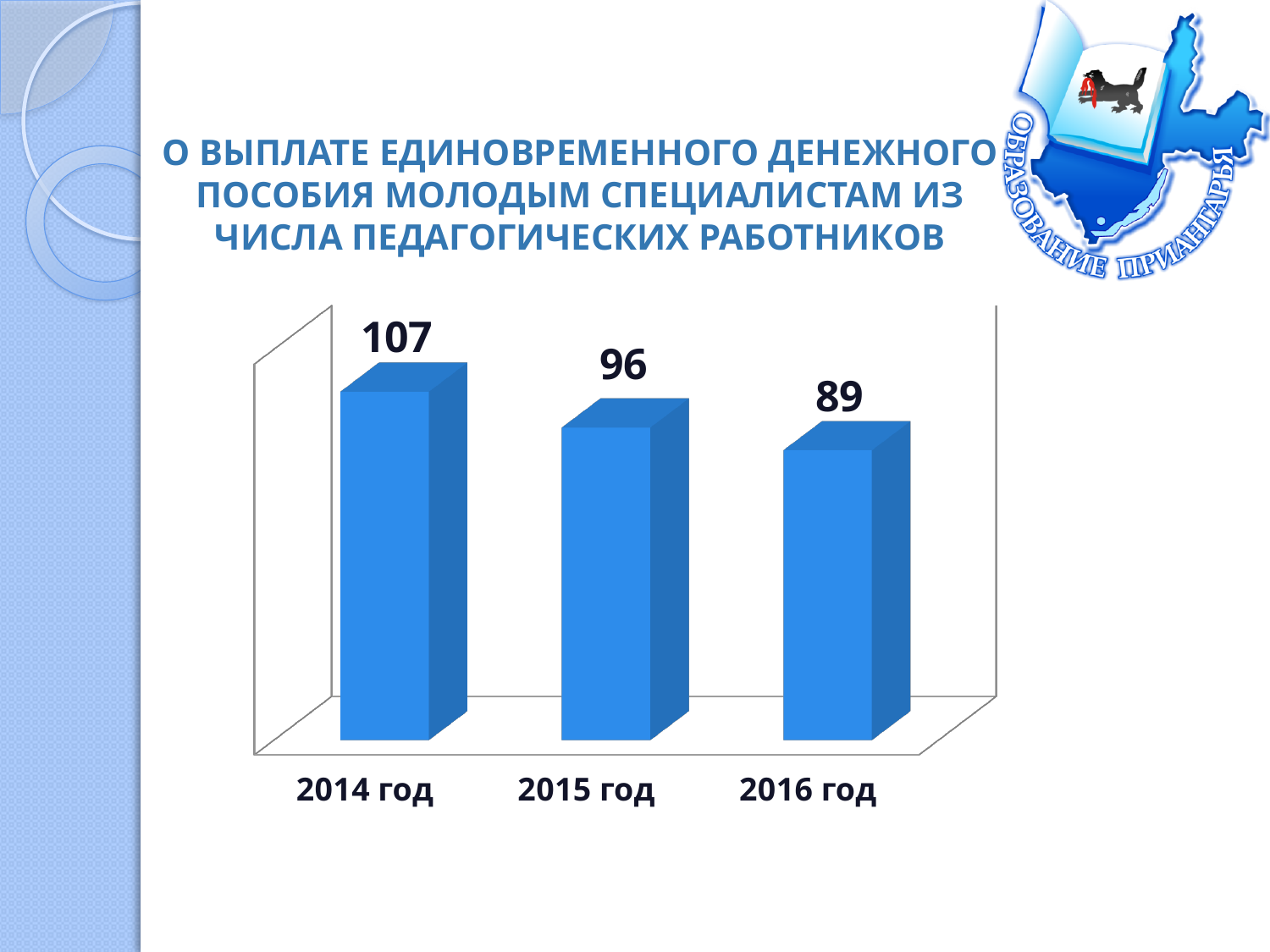
What is the difference between the values for 2014 год and 2015 год? 11 Do the values rise or fall from 2014 год to 2016 год? fall What is the value for 2016 год? 89 What colour are the bars in the chart? blue What is the difference between the values for 2014 год and 2016 год? 18 What is the value for 2014 год? 107 Which year has the lowest value? 2016 год How many years are shown on the chart? 3 What is the value for 2015 год? 96 What kind of chart is shown on the slide? bar chart Which is larger, the value for 2015 год or the value for 2016 год? 2015 год Which year has the highest value? 2014 год